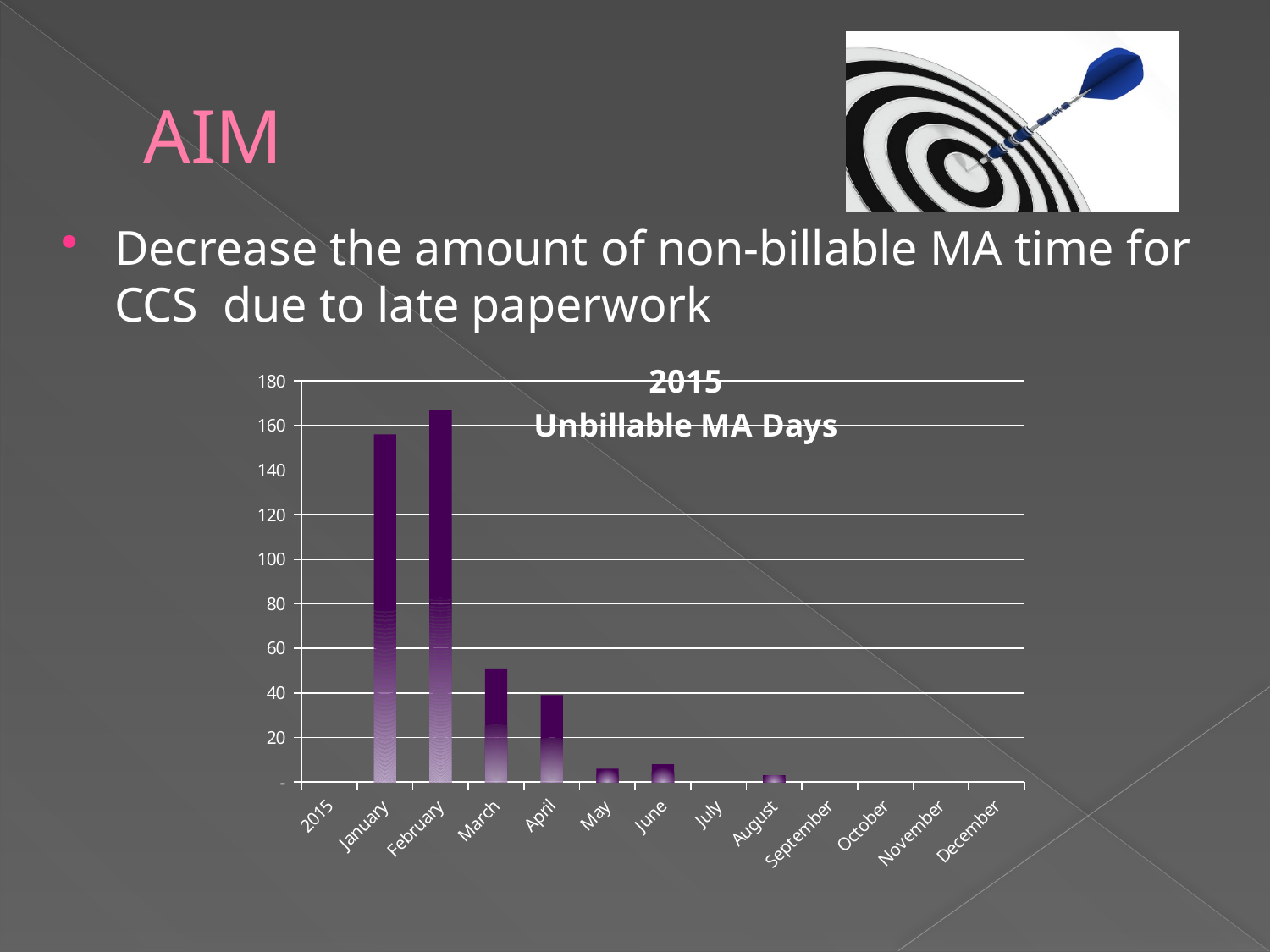
What kind of chart is shown on the slide? bar chart Is the value for April greater or less than 20? greater Which is larger, the value for January or the value for February? February How many category labels are shown on the x axis? 13 Is the value for May greater or less than 20? less What is the title of the chart? 2015 Unbillable MA Days Is the value for March greater or less than 60? less Do the values generally rise or fall from February through August? fall Which is larger, the value for March or the value for April? March Which month has the highest number of unbillable MA days? February